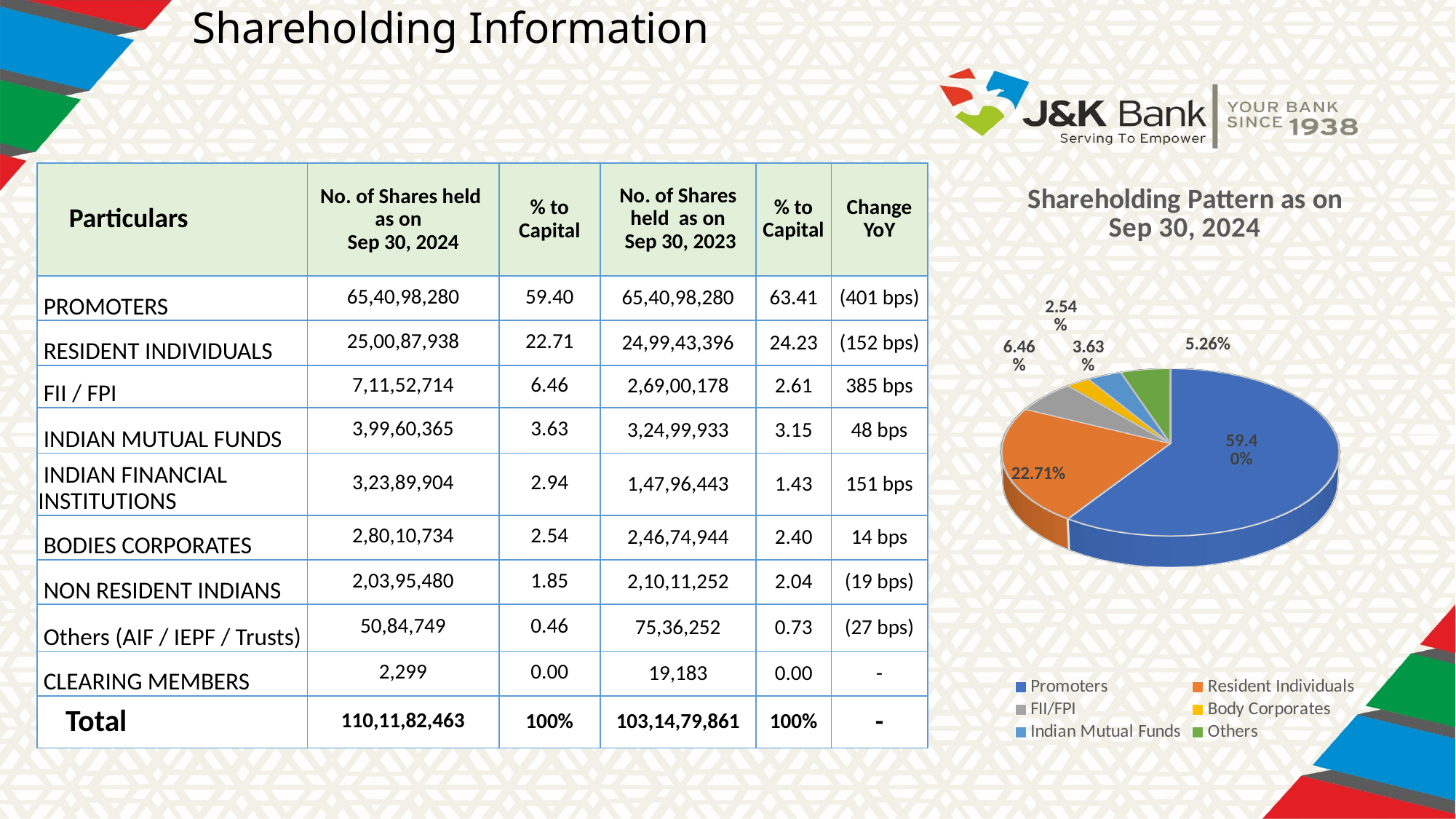
In the pie chart, what share is shown for FII/FPI? 6.46% In the pie chart, which is larger: the FII/FPI slice or the Others slice? FII/FPI In the pie chart, what share is shown for Others? 5.26% What colour is the Promoters slice in the pie chart? blue In the pie chart, what is the difference between the Promoters share and the Resident Individuals share? 36.69% Which category has the smallest slice in the pie chart? Body Corporates How many categories does the legend of the pie chart list? 6 In the pie chart, what share is shown for Indian Mutual Funds? 3.63% What kind of chart is shown under the title "Shareholding Pattern as on Sep 30, 2024"? pie chart In the pie chart, what share is shown for Resident Individuals? 22.71% Which category has the largest slice in the pie chart? Promoters In the pie chart, what share of shareholding is held by Promoters? 59.40%